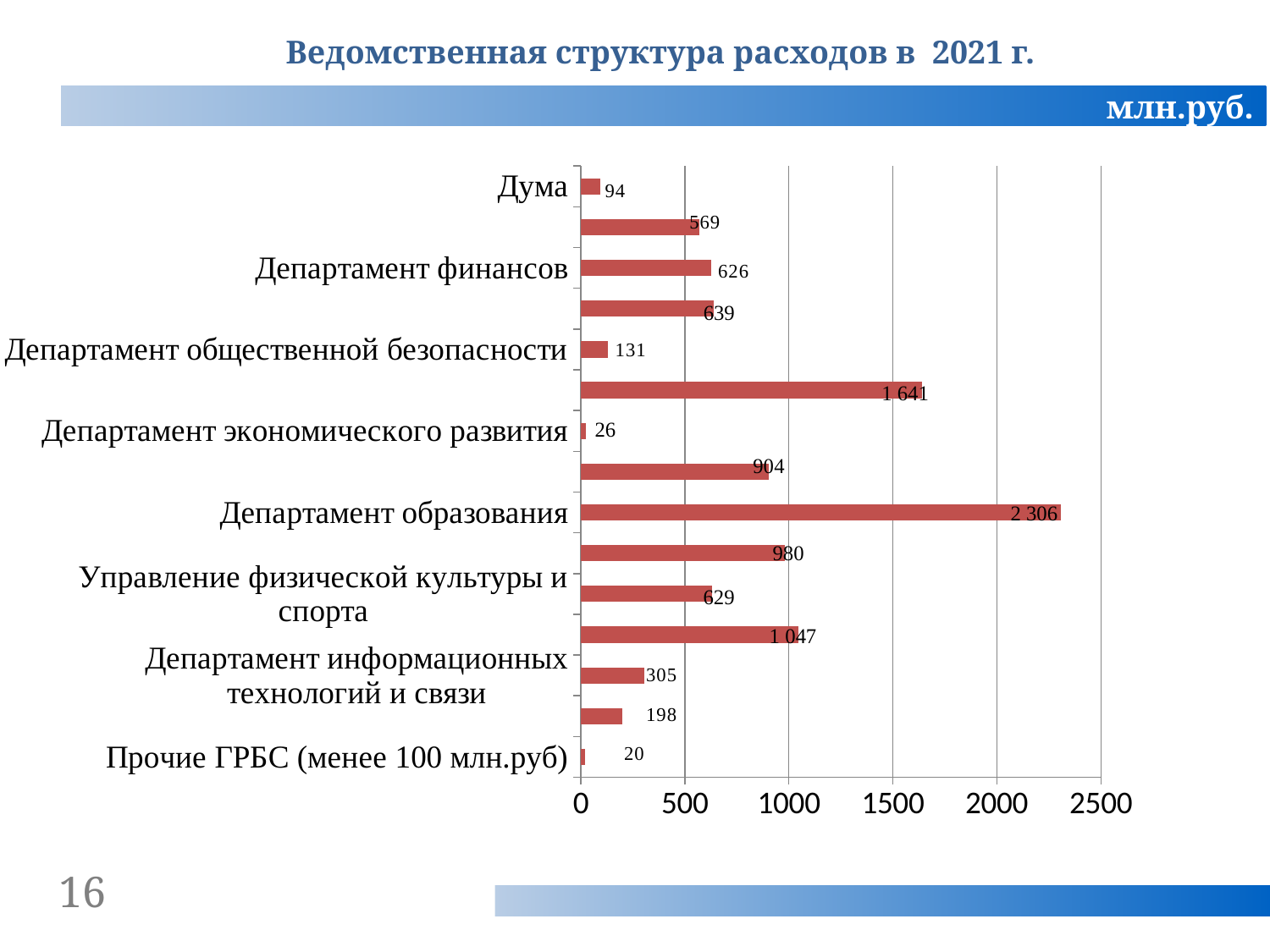
What is the difference between the values for Департамент образования and Департамент финансов? 1 680 What is the value for Департамент информационных технологий и связи? 305 What is the value for Департамент образования? 2 306 What kind of chart is shown on the slide? bar chart Which labelled category has the highest value? Департамент образования What is the value for Департамент общественной безопасности? 131 What is the value for Прочие ГРБС (менее 100 млн.руб)? 20 What is the title of the chart? Ведомственная структура расходов в 2021 г. Which labelled category has the lowest value? Прочие ГРБС (менее 100 млн.руб) What is the value for Дума? 94 Which is larger, the value for Дума or the value for Департамент общественной безопасности? Департамент общественной безопасности Is the value for Департамент образования greater or less than 2000? greater